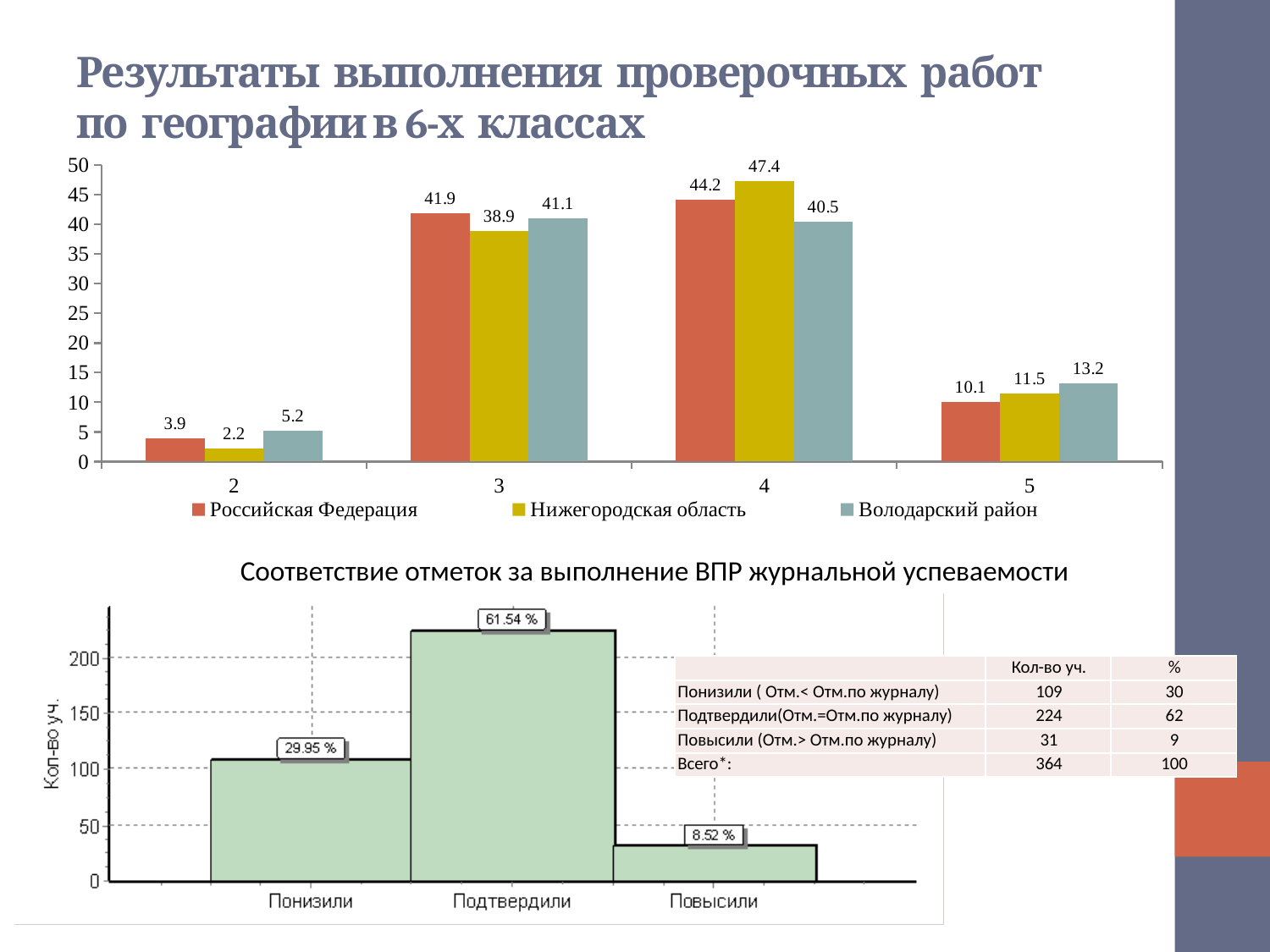
In the top chart, which grade has the highest value for Российская Федерация? 4 In the top chart, what is the value for Нижегородская область for grade 4? 47.4 In the top chart, which is larger for grade 3: Российская Федерация or Нижегородская область? Российская Федерация In the top chart, what is the value for Российская Федерация for grade 5? 10.1 In the top chart, what is the difference between Володарский район and Российская Федерация for grade 5? 3.1 What kind of chart is the bottom chart? bar chart In the bottom chart, is the value for Повысили greater or less than 50? less In the bottom chart, what percentage is shown for Подтвердили? 61.54 % In the top chart, what is the value for Володарский район for grade 2? 5.2 In the top chart, which grade has the lowest value for Нижегородская область? 2 How many grade categories are shown on the x axis of the top chart? 4 How many series does the legend of the top chart list? 3